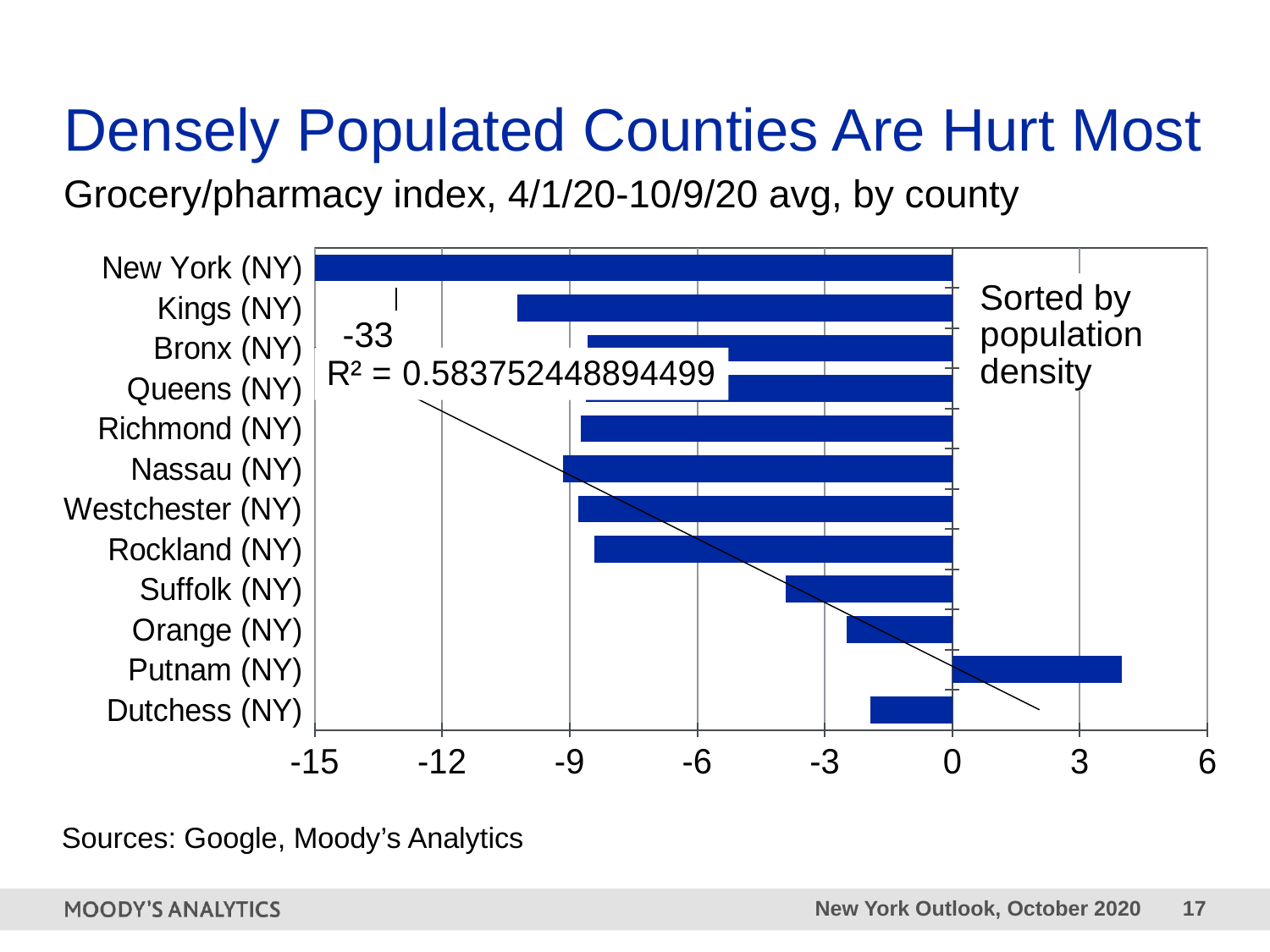
Is the value for Suffolk (NY) greater or less than -6? greater Is the value for Putnam (NY) greater or less than 3? greater What is the value printed for New York (NY)? -33 Which county has the lowest (most negative) value? New York (NY) According to the annotation, how are the counties sorted? By population density Which has the larger value, Kings (NY) or Queens (NY)? Queens (NY) What kind of chart is shown on the slide? bar chart How many counties are plotted in the chart? 12 Is the value for Orange (NY) greater or less than -3? greater Which county has the highest value? Putnam (NY) What R² value is printed on the chart? R² = 0.583752448894499